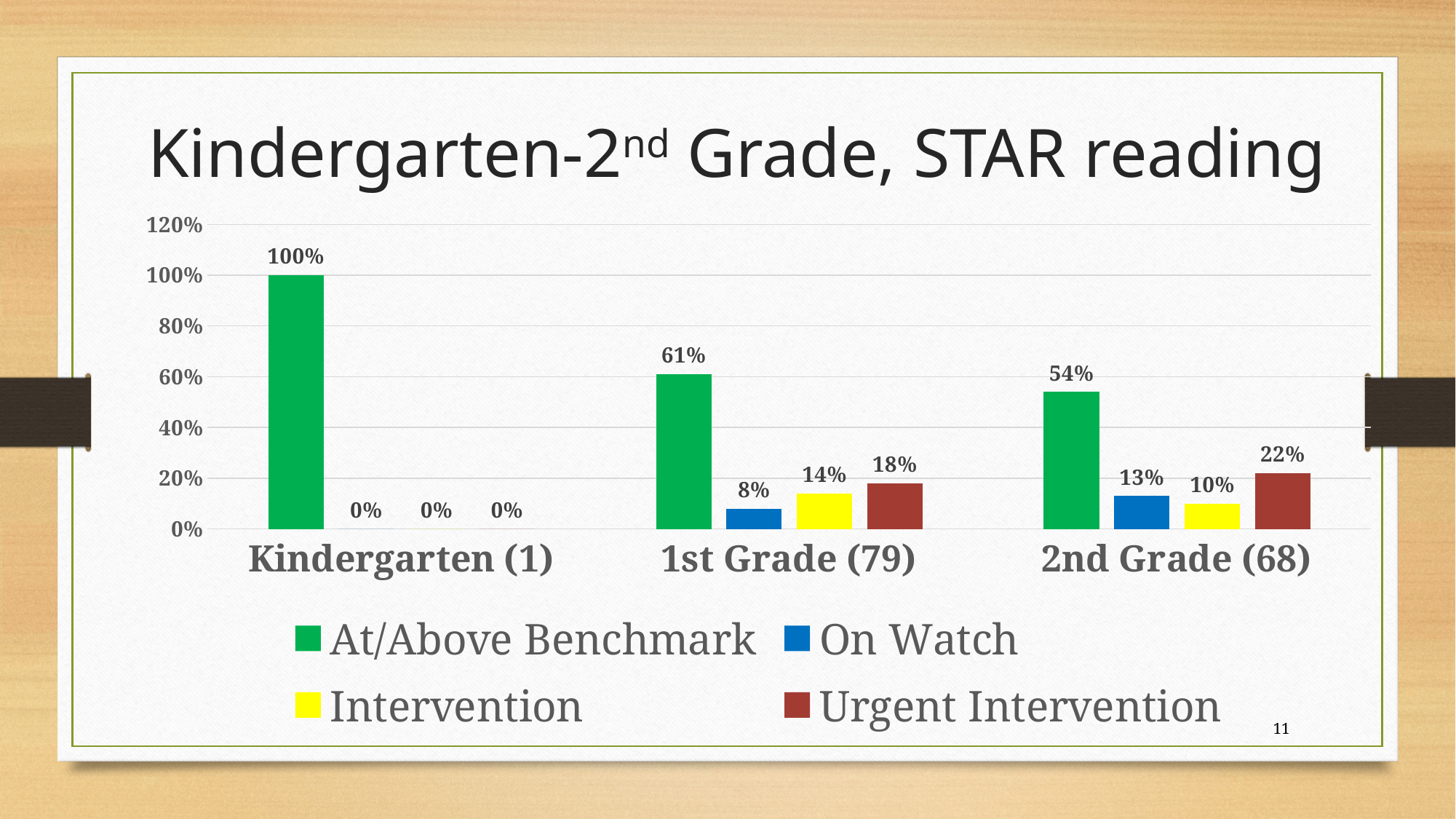
How many grade categories are shown on the x axis? 3 What is the Urgent Intervention value for 2nd Grade (68)? 22% What is the At/Above Benchmark value for 1st Grade (79)? 61% How many series does the legend list? 4 Which colour represents the Intervention series in the legend? Yellow What kind of chart is shown on the slide? Bar chart What is the On Watch value for 1st Grade (79)? 8% Which grade has the highest At/Above Benchmark value? Kindergarten (1) Which is larger, the Urgent Intervention value for 1st Grade (79) or for 2nd Grade (68)? 2nd Grade (68) What is the difference between the At/Above Benchmark values for 1st Grade (79) and 2nd Grade (68)? 7% What is the Intervention value for 2nd Grade (68)? 10% Which grade has the lowest At/Above Benchmark value? 2nd Grade (68)